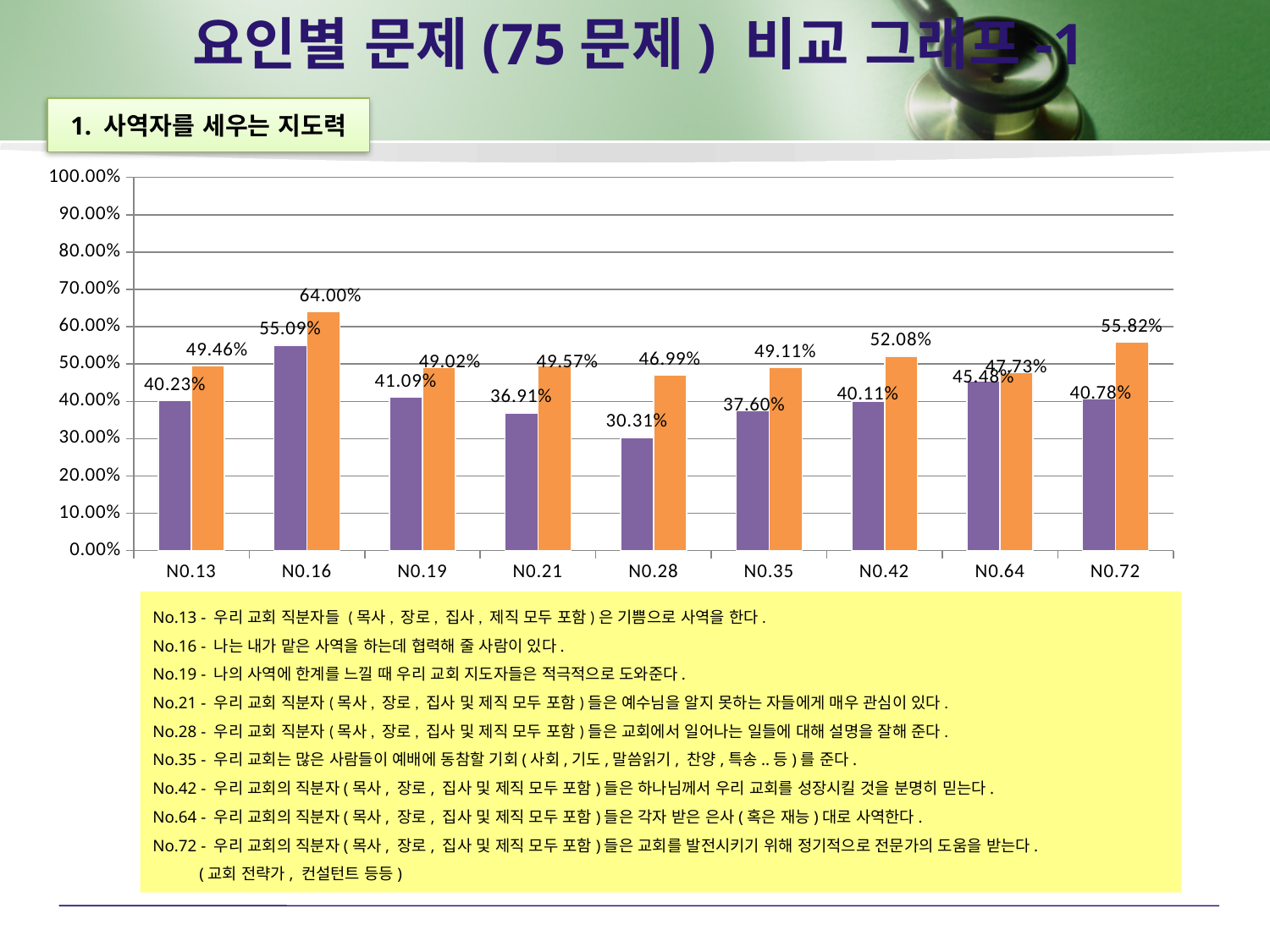
What is the value of the purple bar for N0.13? 40.23% Which category has the highest orange bar? N0.16 How many categories are shown on the x axis? 9 Which is larger for N0.64, the purple bar or the orange bar? the orange bar What is the difference between the orange and purple bars for N0.28? 16.68% What is the value of the orange bar for N0.16? 64.00% What is the value of the purple bar for N0.28? 30.31% What is the maximum value shown on the y axis? 100.00% Which category has the lowest purple bar? N0.28 Is the value of the orange bar for N0.42 greater or less than 50.00%? greater What is the value of the orange bar for N0.72? 55.82% What kind of chart is shown on the slide? bar chart